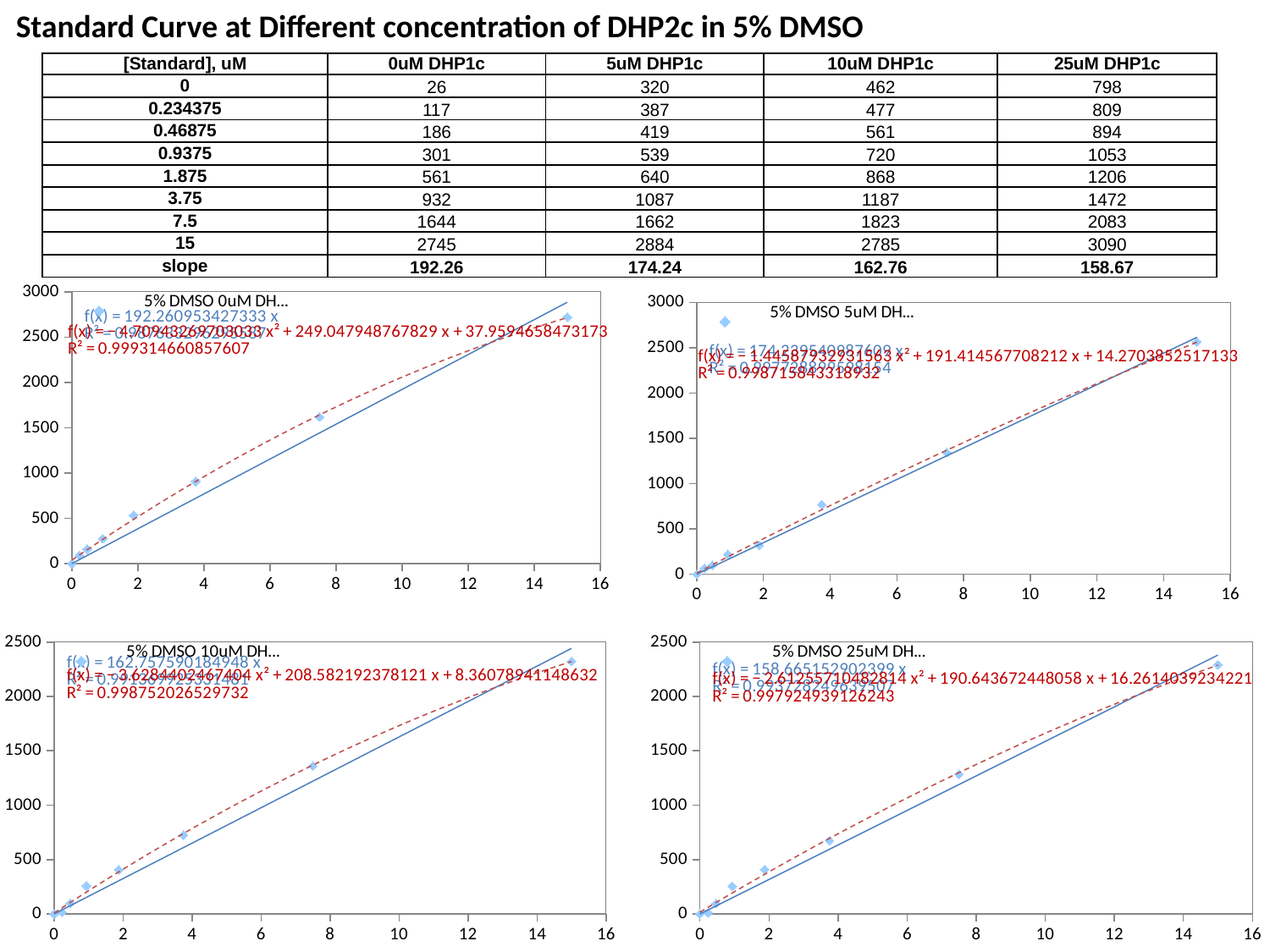
In the top-left chart (5% DMSO 0uM DH...), is the value of the point at x = 3.75 greater or less than 1000? less In the bottom-left chart (5% DMSO 10uM DH...), is the value of the point at x = 15 greater or less than 2000? greater What is the slope shown in the blue linear fit equation on the top-left chart (5% DMSO 0uM DH...)? 192.260953427333 In the bottom-right chart (5% DMSO 25uM DH...), is the value of the point at x = 3.75 greater or less than 500? greater In the bottom-right chart (5% DMSO 25uM DH...), do the plotted values rise or fall along the x axis? Rise What kind of chart is the top-left chart titled "5% DMSO 0uM DH..."? Scatter chart with trendlines In the top-left chart (5% DMSO 0uM DH...), do the plotted values rise or fall as the x value increases? Rise What is the maximum value shown on the y axis of the bottom-left chart (5% DMSO 10uM DH...)? 2500